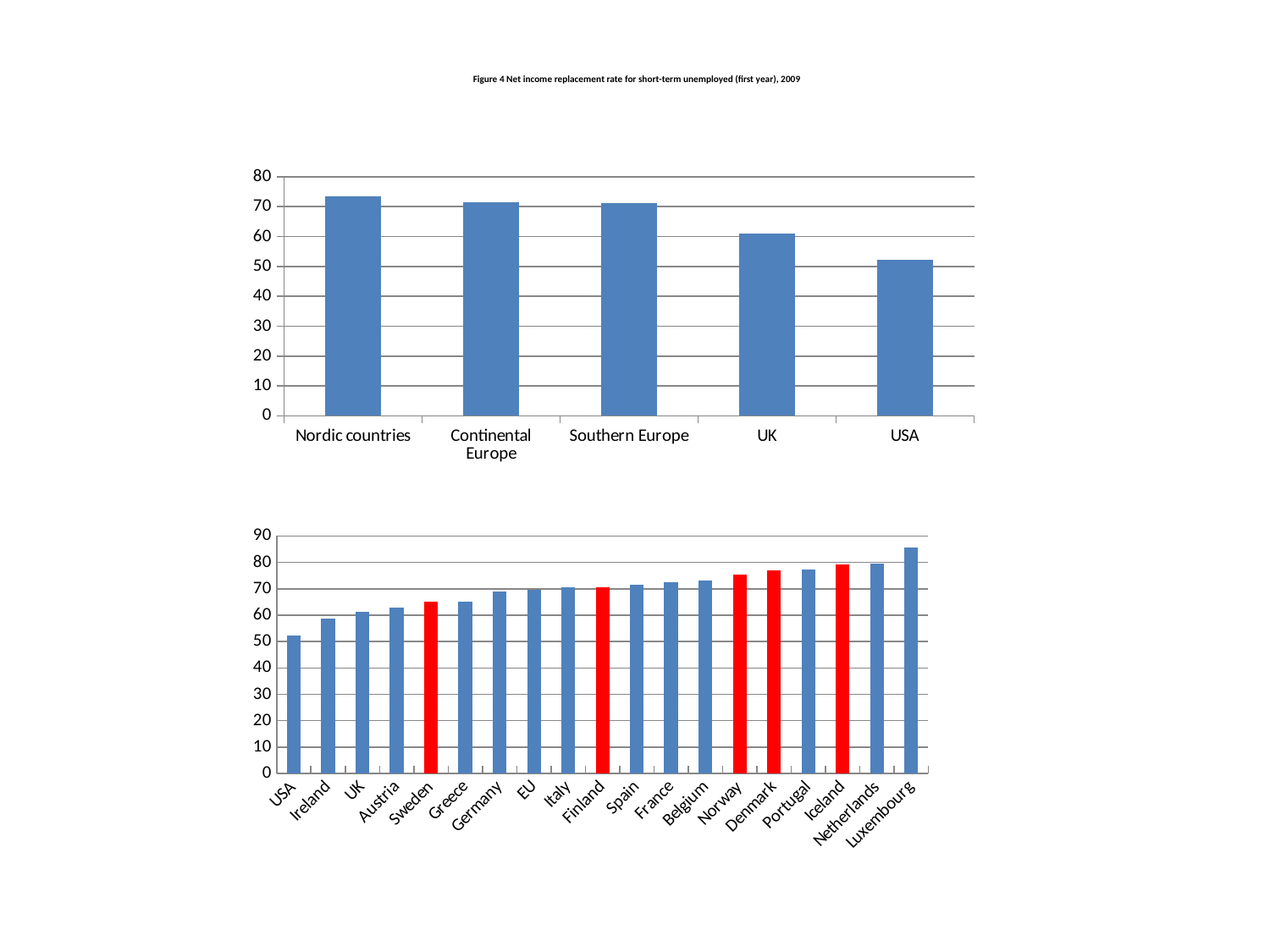
In the bottom chart, which bars are coloured red? Sweden, Finland, Norway, Denmark, Iceland In the top chart, which is larger, the value for UK or the value for USA? UK In the bottom chart, which country has the highest value? Luxembourg In the top chart, which category has the highest value? Nordic countries In the top chart, which category has the lowest value? USA In the bottom chart, how many countries or regions are shown on the x axis? 19 In the top chart, is the value for USA greater or less than 60? less In the top chart, is the value for Nordic countries greater or less than 70? greater In the top chart, how many categories are shown? 5 In the bottom chart, do the values rise or fall from left to right along the x axis? rise What kind of chart is the top chart on the slide? bar chart In the bottom chart, which country has the lowest value? USA